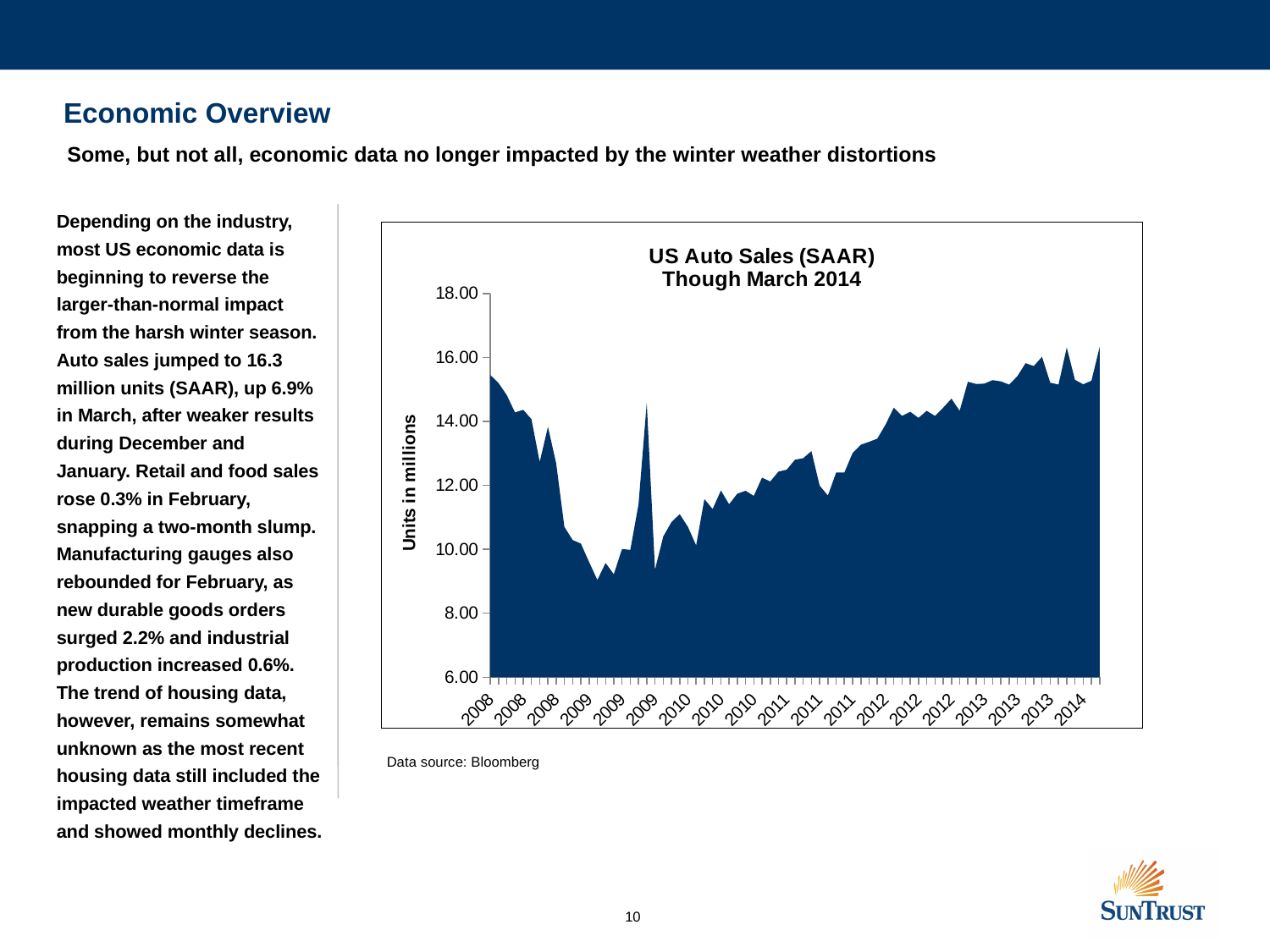
Is the lowest value reached in 2009 greater or less than 10.00? less What is the title of the chart? US Auto Sales (SAAR) Though March 2014 Is the value at the end of the series in 2014 greater or less than 14.00? greater Do auto sales generally rise or fall from early 2008 to early 2009? fall What is the label on the vertical axis of the chart? Units in millions What kind of chart is used to show US Auto Sales (SAAR)? area chart Is the value in late 2013 greater or less than 12.00? greater Which is larger, the value at the start of 2008 or the value at the start of 2010? the value at the start of 2008 Do auto sales generally rise or fall from 2010 to 2014? rise What is the highest value shown on the vertical axis? 18.00